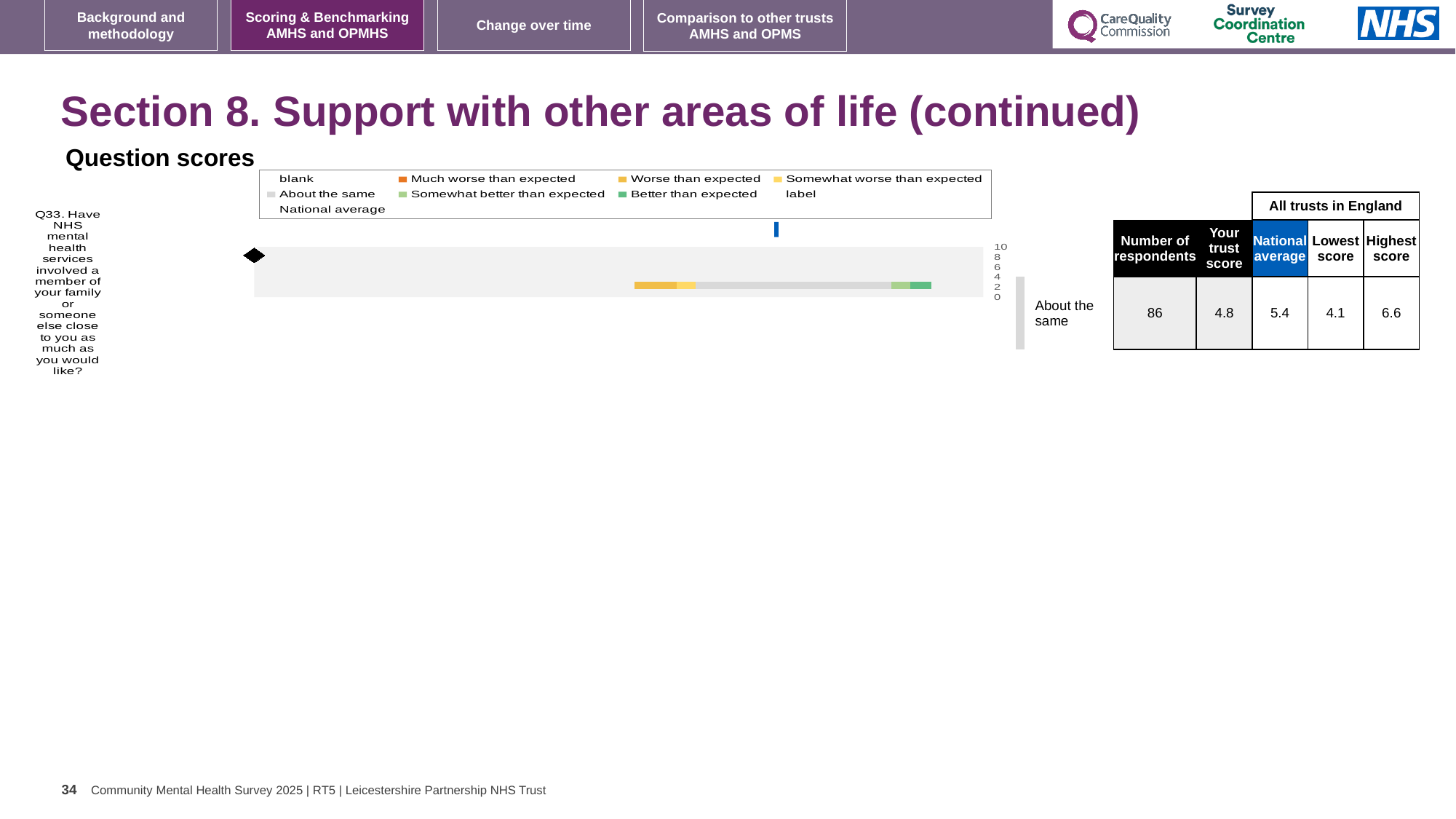
In the table beside the chart, what is the trust's score for Q33? 4.8 In the table beside the chart, what is the lowest score among all trusts in England for Q33? 4.1 For Q33, which is larger: the trust's score or the national average? National average In the table beside the chart, what is the number of respondents for Q33? 86 In the table beside the chart, what is the highest score among all trusts in England for Q33? 6.6 Which question number is plotted in the Question scores chart? Q33 What kind of chart is shown under 'Question scores'? bar chart How many entries does the legend of the Question scores chart list? 9 What is the highest value shown on the axis of the Question scores chart? 10 In the table beside the chart, what is the national average for Q33? 5.4 How many survey questions are plotted in the Question scores chart? 1 For Q33, what is the difference between the highest score and the lowest score among all trusts in England? 2.5